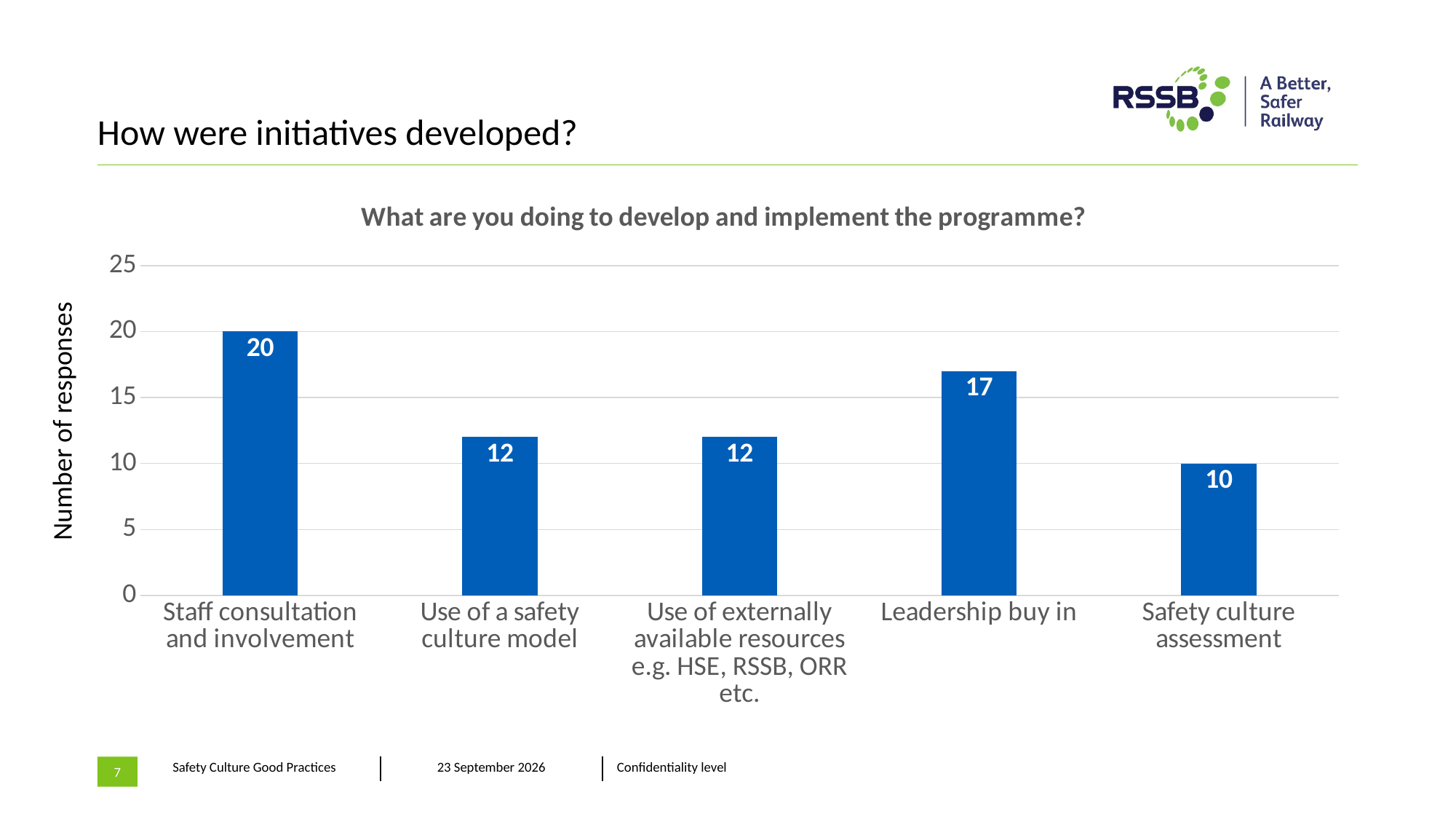
Which category has the highest number of responses? Staff consultation and involvement What type of chart is shown on the slide? Bar chart What is the number of responses for Leadership buy in? 17 Which category has the lowest number of responses? Safety culture assessment What is the label on the vertical axis of the chart? Number of responses How many responses were recorded for Staff consultation and involvement? 20 What is the value for Use of a safety culture model? 12 What is the difference in responses between Staff consultation and involvement and Leadership buy in? 3 Is the value for Leadership buy in greater or less than 15? greater How many responses did Safety culture assessment receive? 10 Which has more responses: Leadership buy in or Use of externally available resources e.g. HSE, RSSB, ORR etc.? Leadership buy in How many categories are shown on the chart? 5